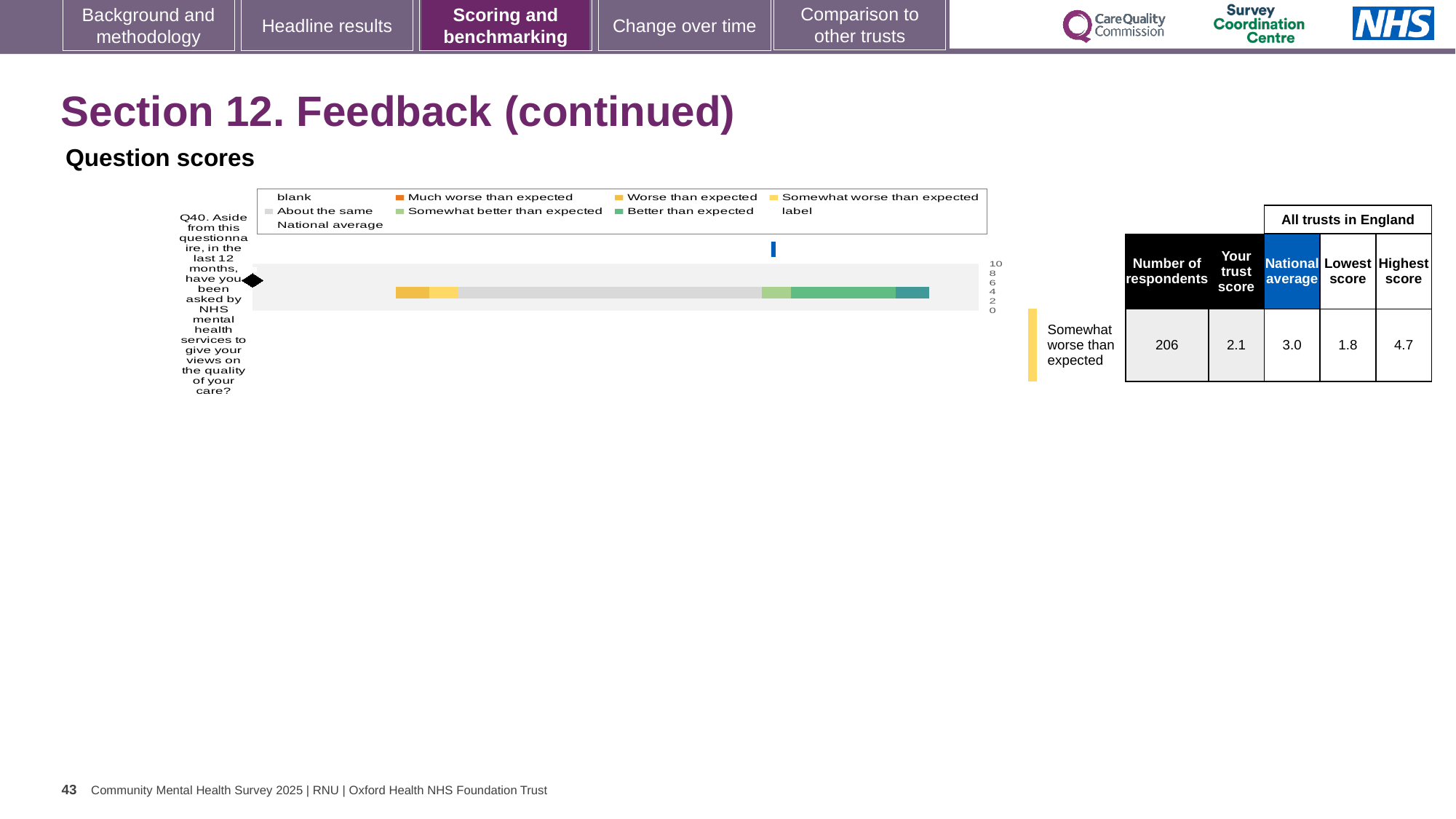
What is the lowest score among all trusts in England for Q40? 1.8 What is the national average score for Q40? 3.0 What is the trust's score for Q40? 2.1 How many respondents answered Q40? 206 What is the difference between the national average and the trust's score for Q40? 0.9 How many entries does the chart legend list? 9 Which is larger for Q40, the trust's score or the national average? national average Which benchmarking category is the trust's Q40 score placed in? Somewhat worse than expected What kind of chart is used to show the Q40 question score? bar chart What is the highest score among all trusts in England for Q40? 4.7 Which question is plotted on the chart? Q40. Aside from this questionnaire, in the last 12 months, have you been asked by NHS mental health services to give your views on the quality of your care? How many survey questions are plotted on the chart? 1